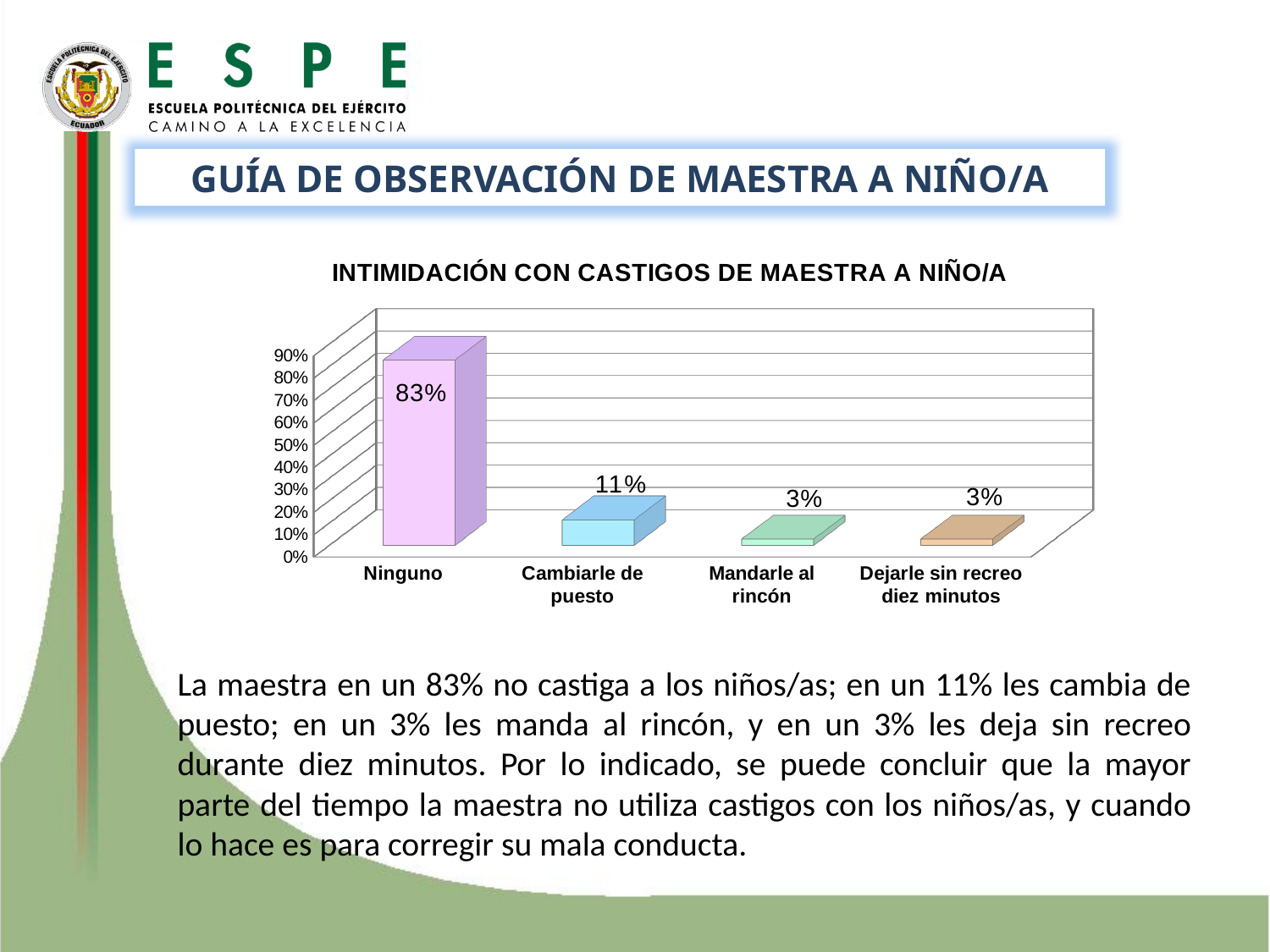
What is the value for Cambiarle de puesto? 11% What is the value for Mandarle al rincón? 3% What is the difference between the values for Ninguno and Cambiarle de puesto? 72% What is the title of the chart? INTIMIDACIÓN CON CASTIGOS DE MAESTRA A NIÑO/A What is the value for Ninguno? 83% Do the values rise or fall from left to right along the x axis? fall How many categories are shown on the x axis? 4 What is the value for Dejarle sin recreo diez minutos? 3% Which category has the highest value? Ninguno Is the value for Ninguno greater or less than 50%? greater Which is larger, the value for Cambiarle de puesto or the value for Mandarle al rincón? Cambiarle de puesto What kind of chart is shown on the slide? bar chart